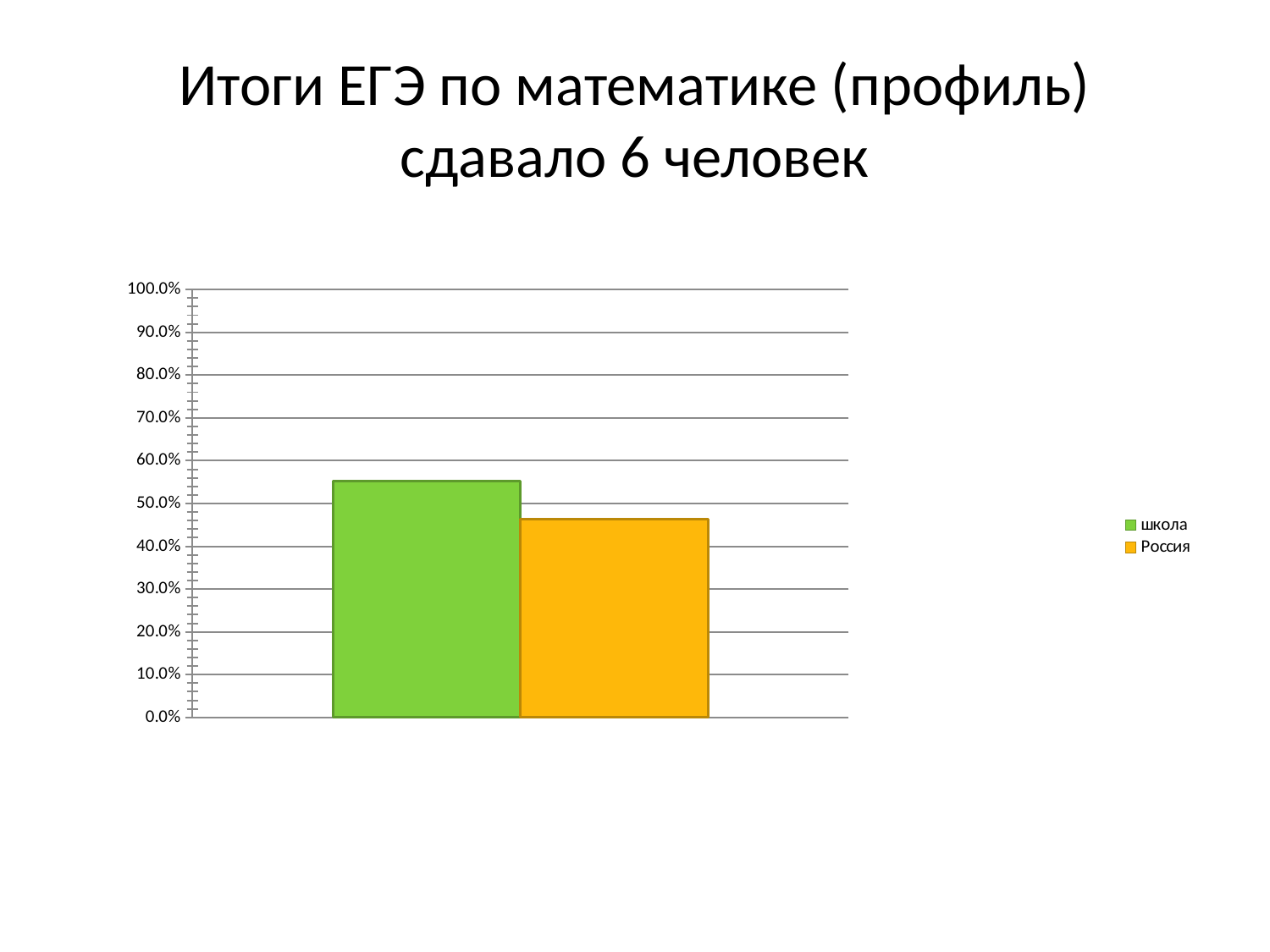
What kind of chart is shown on the slide? bar chart Is the value for Россия greater or less than 40.0%? greater Is the value for школа greater or less than 50.0%? greater Is the value for школа greater or less than 60.0%? less Which series has the higher value, школа or Россия? школа How many series does the legend list? 2 Which series has the highest value? школа What is the highest value shown on the vertical axis? 100.0% What colour is the bar for the series Россия? orange How many bars are plotted on the chart? 2 Which series has the lowest value? Россия